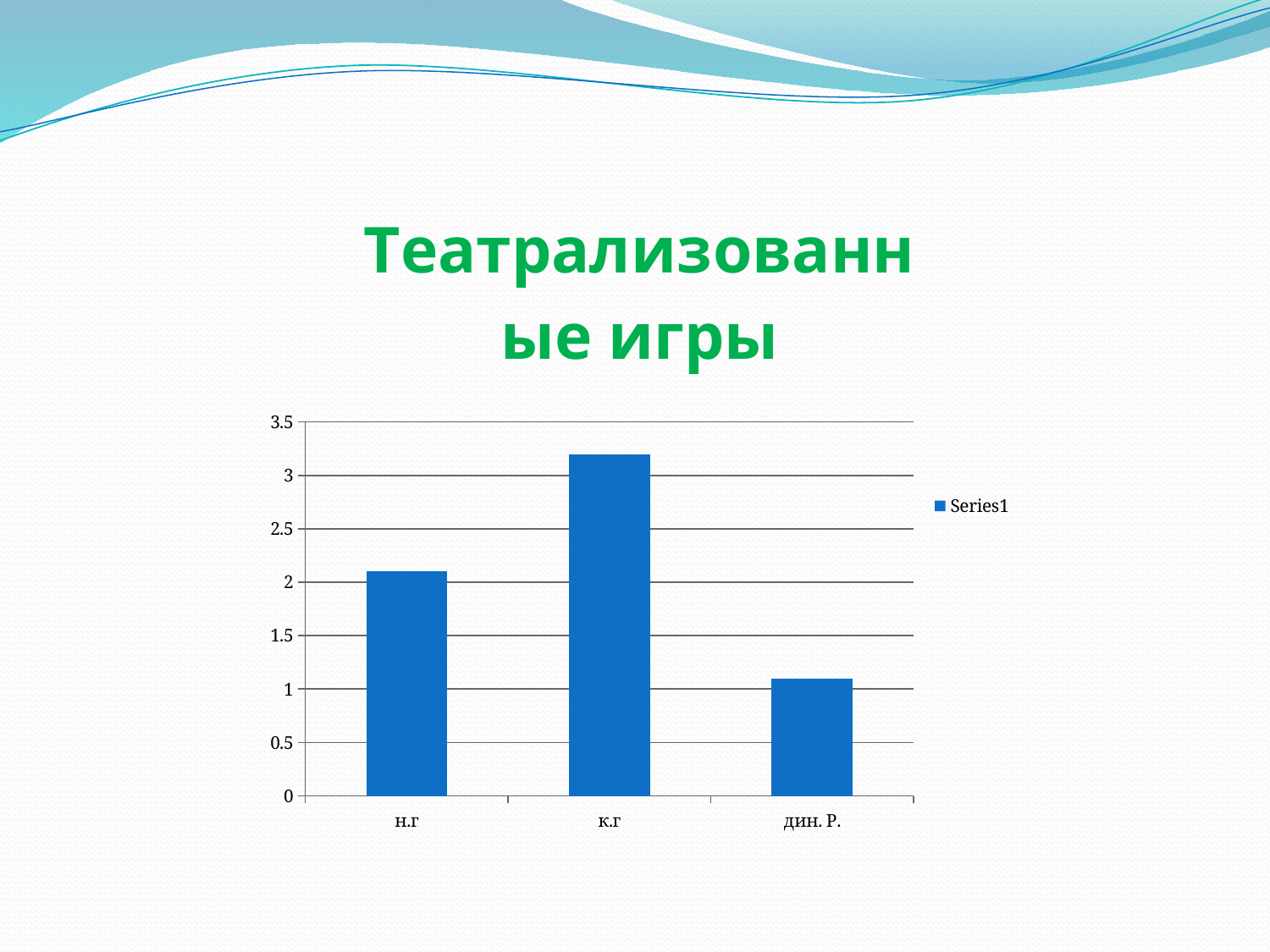
What kind of chart is shown on the slide? bar chart Which category has the lowest value in the chart? дин. Р. Does the value rise or fall from н.г to к.г? rise What is the title shown above the chart? Театрализованные игры Is the value for к.г greater or less than 3? greater How many categories are shown on the x axis of the chart? 3 What is the name of the series listed in the chart's legend? Series1 Is the value for н.г greater or less than 2.5? less Which category has the highest value in the chart? к.г Which is larger, the value for н.г or the value for дин. Р.? н.г How many series does the chart's legend list? 1 Is the value for дин. Р. greater or less than 1.5? less